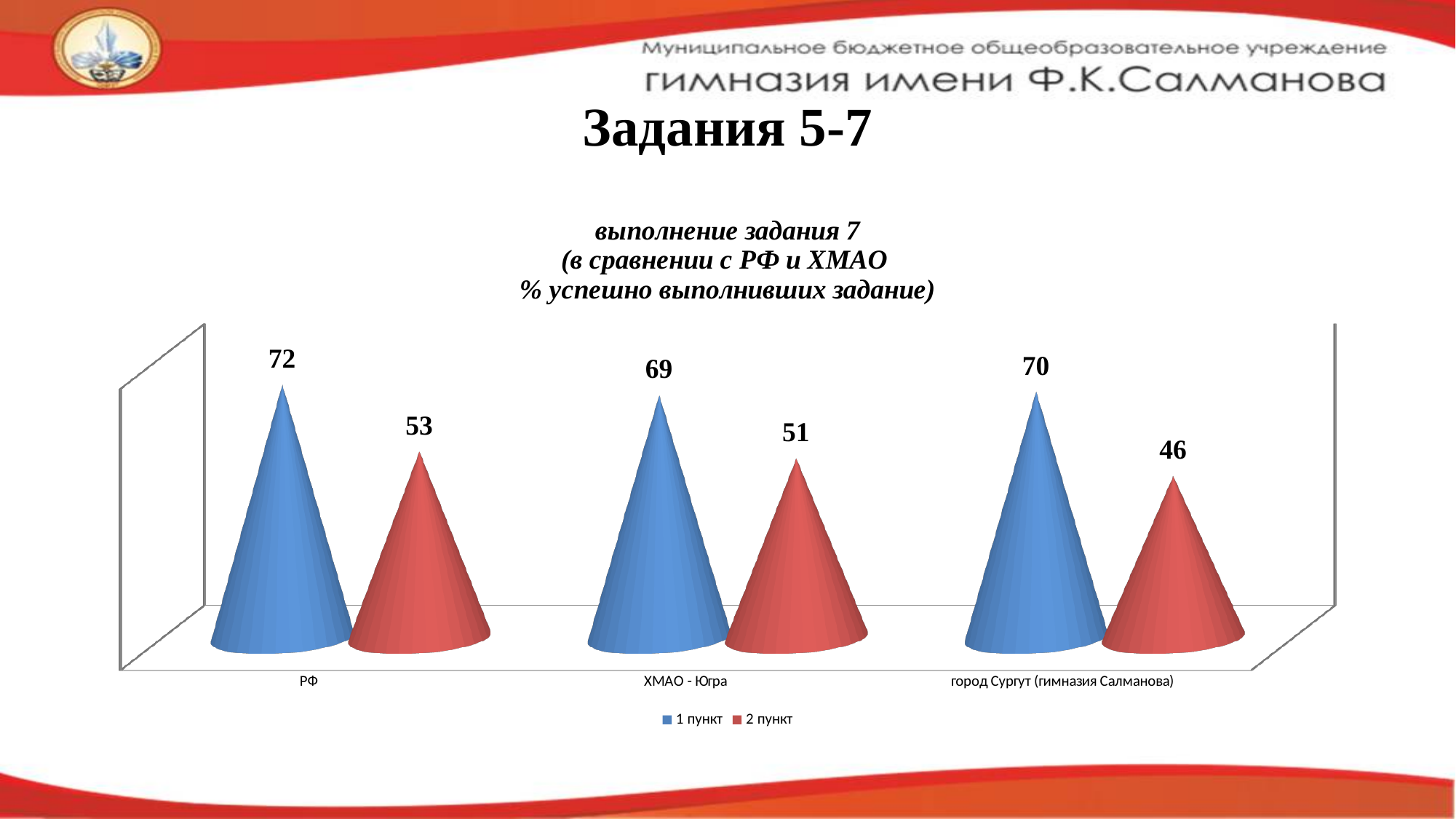
What kind of chart is shown on the slide? bar chart How many series does the legend list? 2 How many categories are shown on the x axis? 3 What is the value for "2 пункт" for ХМАО - Югра? 51 What is the difference between the "1 пункт" and "2 пункт" values for РФ? 19 What is the value for "1 пункт" for город Сургут (гимназия Салманова)? 70 Which category has the highest value for "1 пункт"? РФ What is the difference between the "2 пункт" values for РФ and город Сургут (гимназия Салманова)? 7 Which category has the lowest value for "2 пункт"? город Сургут (гимназия Салманова) What is the value for "2 пункт" for город Сургут (гимназия Салманова)? 46 Which is larger: the "1 пункт" value for ХМАО - Югра or the "1 пункт" value for город Сургут (гимназия Салманова)? город Сургут (гимназия Салманова) What is the value for "1 пункт" for РФ? 72